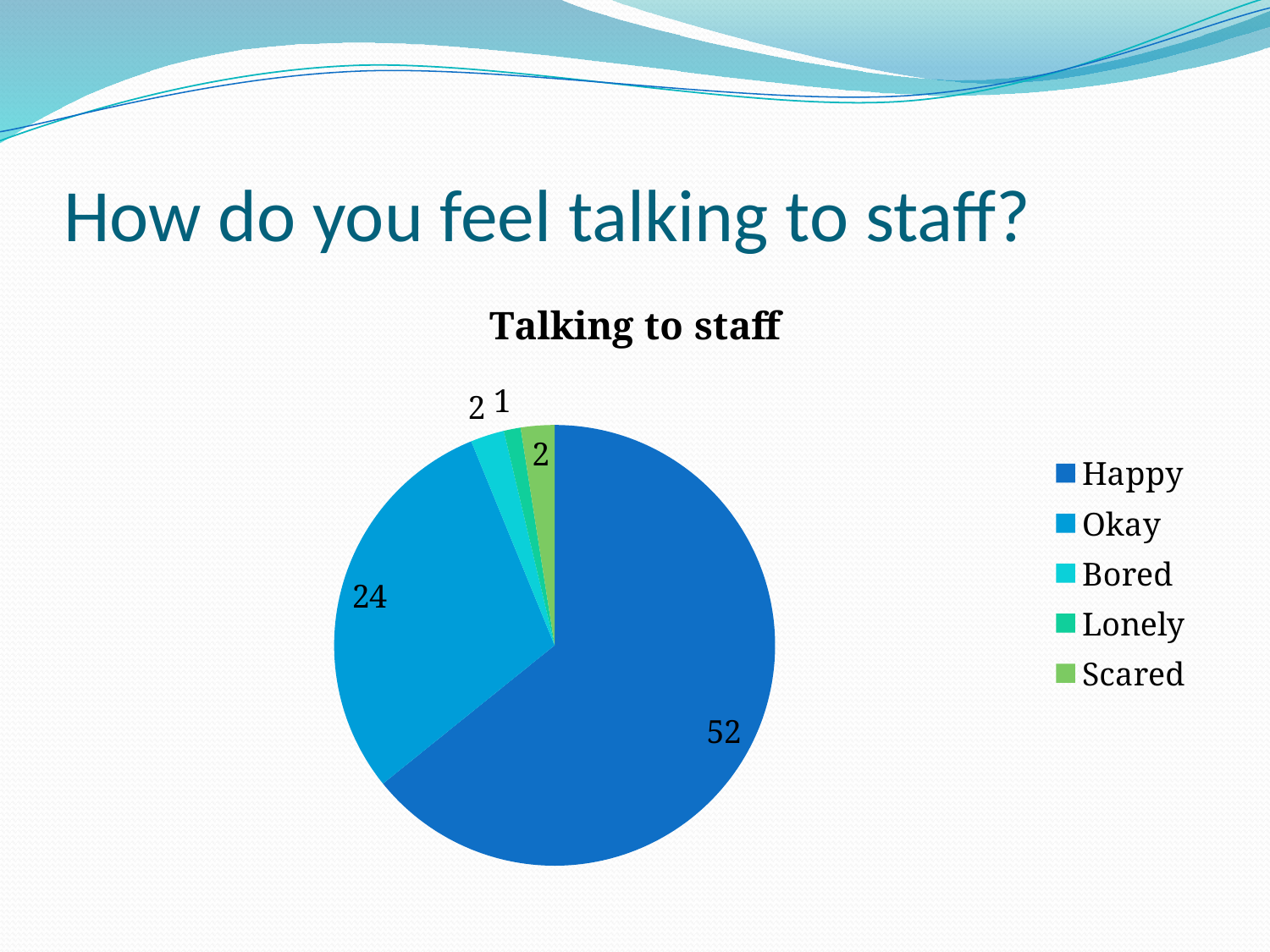
What is the value for Lonely? 1 What is the title of the chart? Talking to staff Which category has the largest slice? Happy What type of chart is shown on the slide? pie chart Which is larger, the value for Okay or the value for Bored? Okay What is the value for Happy? 52 Which category has the smallest slice? Lonely How many categories does the pie chart have? 5 What is the value for Okay? 24 What is the difference between the values for Happy and Okay? 28 How many entries does the legend list? 5 What is the total of all the slice values in the pie chart? 81